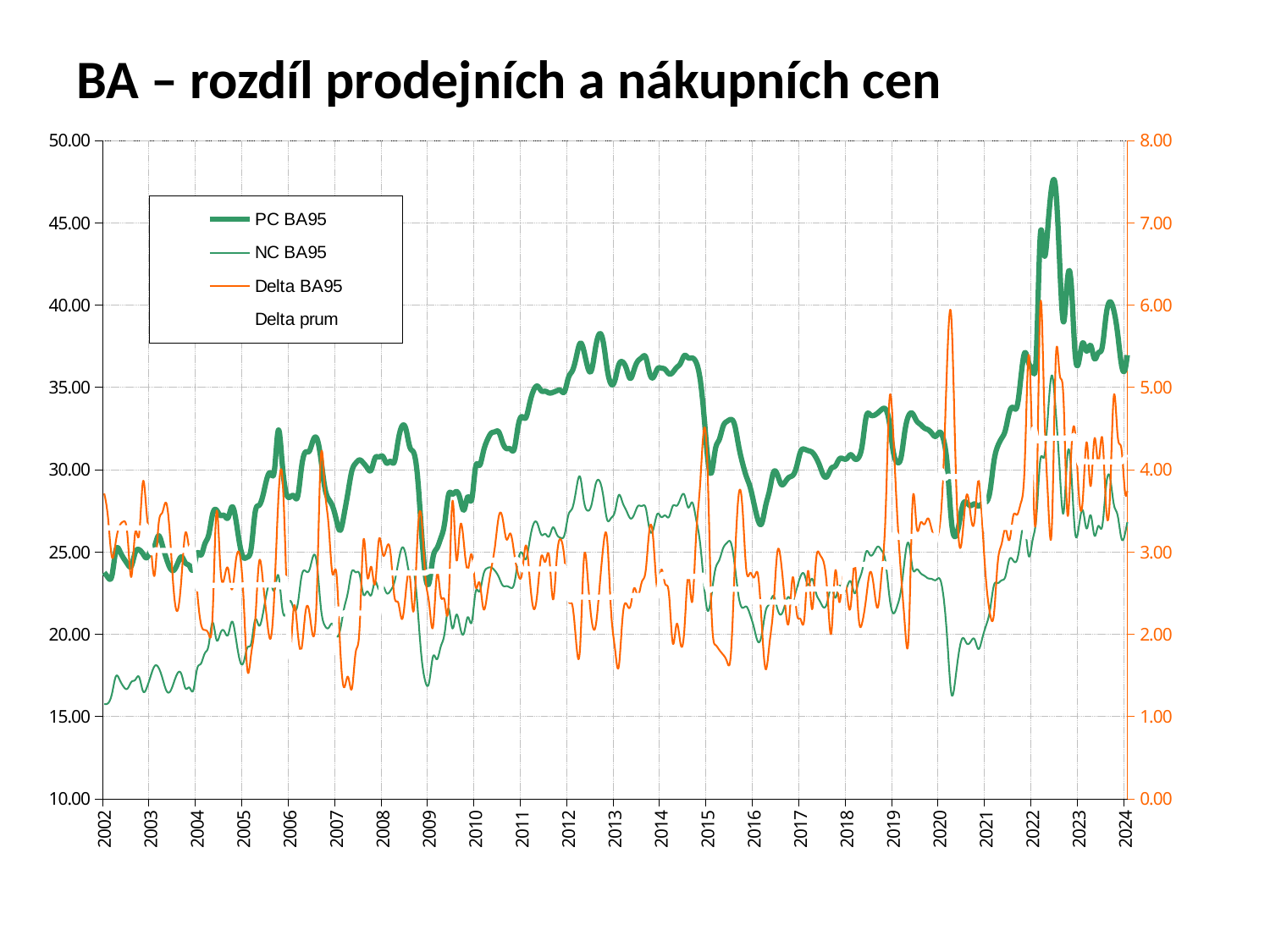
Is the peak value of PC BA95 in 2022 greater or less than 45.00? greater Is PC BA95 higher in 2022 or in 2002? 2022 Is the lowest value of NC BA95 in 2020 greater or less than 20.00? less How many year labels are shown on the x axis? 23 Which series is drawn with the thickest line? PC BA95 What is the title of the chart? BA – rozdíl prodejních a nákupních cen Does PC BA95 overall rise or fall from 2002 to 2024? rise What kind of chart is shown on the slide? line chart Is the value of NC BA95 at the start of 2002 greater or less than 20.00? less How many series does the legend list? 4